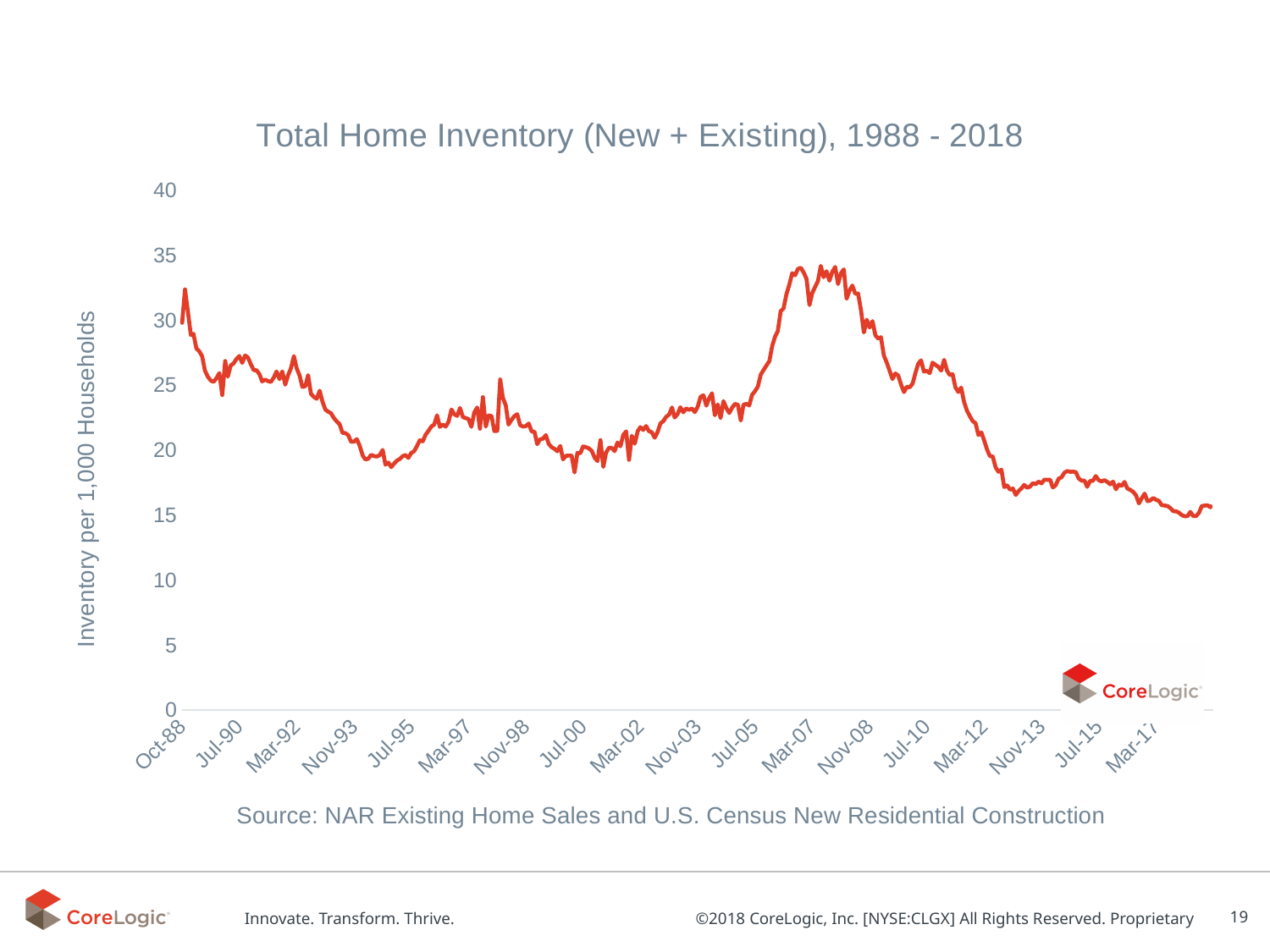
How many date labels are shown along the x axis? 18 Do the values generally rise or fall between Jul-00 and Jul-05? Rise What is the title of the chart? Total Home Inventory (New + Existing), 1988 - 2018 What kind of chart is shown on the slide? Line chart Is the value around Jul-10 greater or less than 20? greater Is the value around Mar-07 greater or less than 30? greater Do the values generally rise or fall between Mar-07 and Mar-17? Fall Is the value around Mar-17 greater or less than 20? less Which is larger, the value around Mar-07 or the value around Jul-95? Mar-07 What is the label on the vertical axis of the chart? Inventory per 1,000 Households